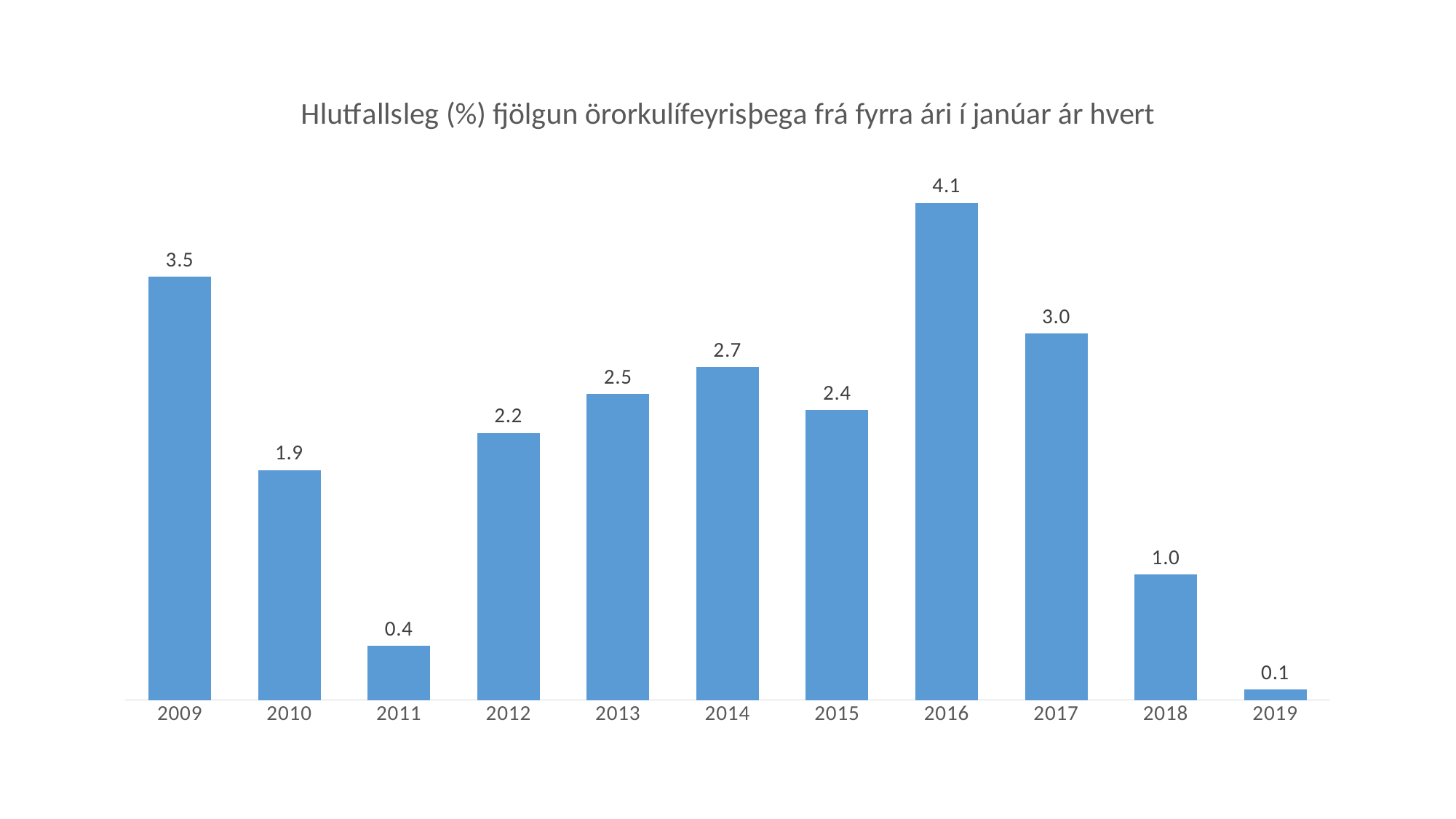
Do the values rise or fall from 2017 to 2019? Fall Which is larger, the value for 2013 or the value for 2015? 2013 What is the difference between the values for 2009 and 2010? 1.6 What is the value for 2017? 3.0 Which year has the lowest value? 2019 What is the value for 2016? 4.1 What is the title of the chart? Hlutfallsleg (%) fjölgun örorkulífeyrisþega frá fyrra ári í janúar ár hvert What is the difference between the values for 2016 and 2017? 1.1 Which year has the highest value? 2016 What kind of chart is this? Bar chart How many years are shown on the x axis? 11 What is the value for 2011? 0.4